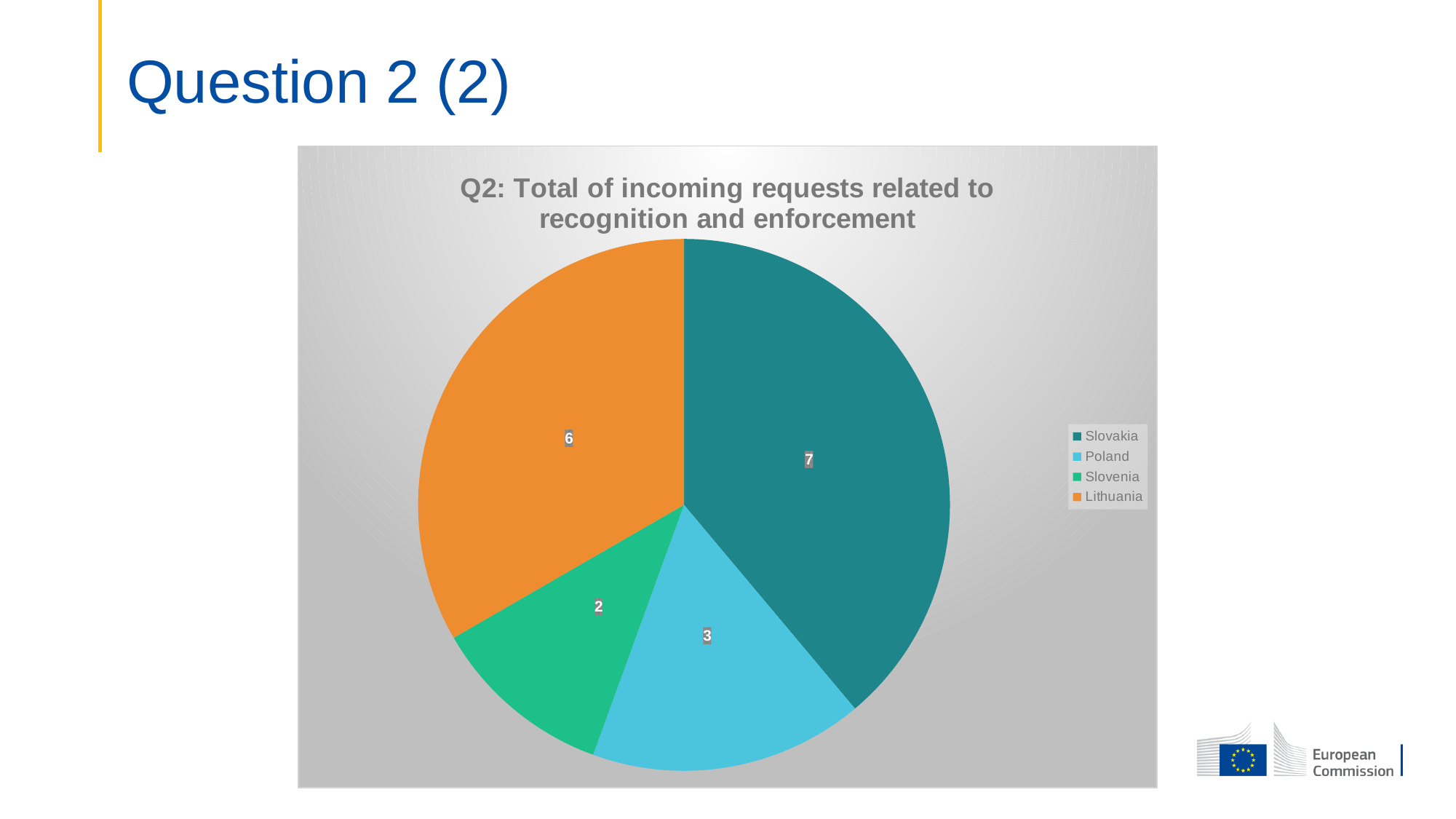
What is the value for Slovakia in the pie chart? 7 What is the value for Lithuania in the pie chart? 6 Which is larger, the value for Lithuania or the value for Poland? Lithuania What is the value for Poland in the pie chart? 3 Which country has the largest slice of the pie chart? Slovakia Which country has the smallest slice of the pie chart? Slovenia What type of chart is shown on the slide? Pie chart What is the value for Slovenia in the pie chart? 2 What is the difference between the values for Slovakia and Poland? 4 What is the total of all the values in the pie chart? 18 What is the title of the chart? Q2: Total of incoming requests related to recognition and enforcement How many countries are shown in the pie chart? 4